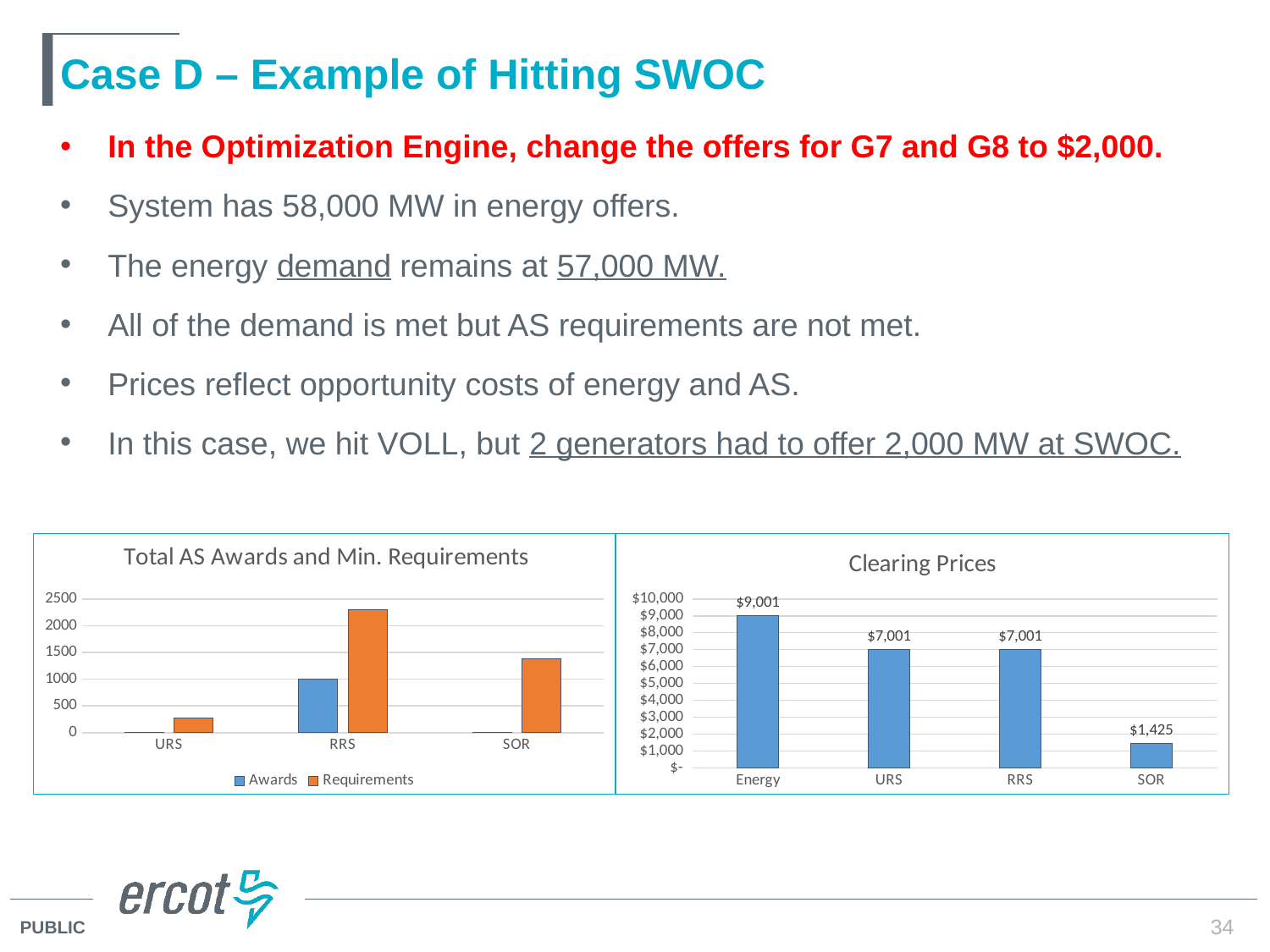
In the Total AS Awards and Min. Requirements chart, is the Requirements value for RRS greater or less than 2000? greater In the Clearing Prices chart, how many categories are shown on the x axis? 4 In the Clearing Prices chart, what is the clearing price for RRS? $7,001 In the Clearing Prices chart, what is the clearing price for SOR? $1,425 In the Clearing Prices chart, what is the difference between the Energy and SOR clearing prices? $7,576 What kind of chart is the Total AS Awards and Min. Requirements chart? Bar chart In the Clearing Prices chart, which category has the highest clearing price? Energy In the Clearing Prices chart, what is the clearing price for Energy? $9,001 In the Clearing Prices chart, which category has the lowest clearing price? SOR In the Clearing Prices chart, what is the difference between the Energy and URS clearing prices? $2,000 In the Total AS Awards and Min. Requirements chart, how many series does the legend list? 2 In the Total AS Awards and Min. Requirements chart, which category has the highest Requirements value? RRS